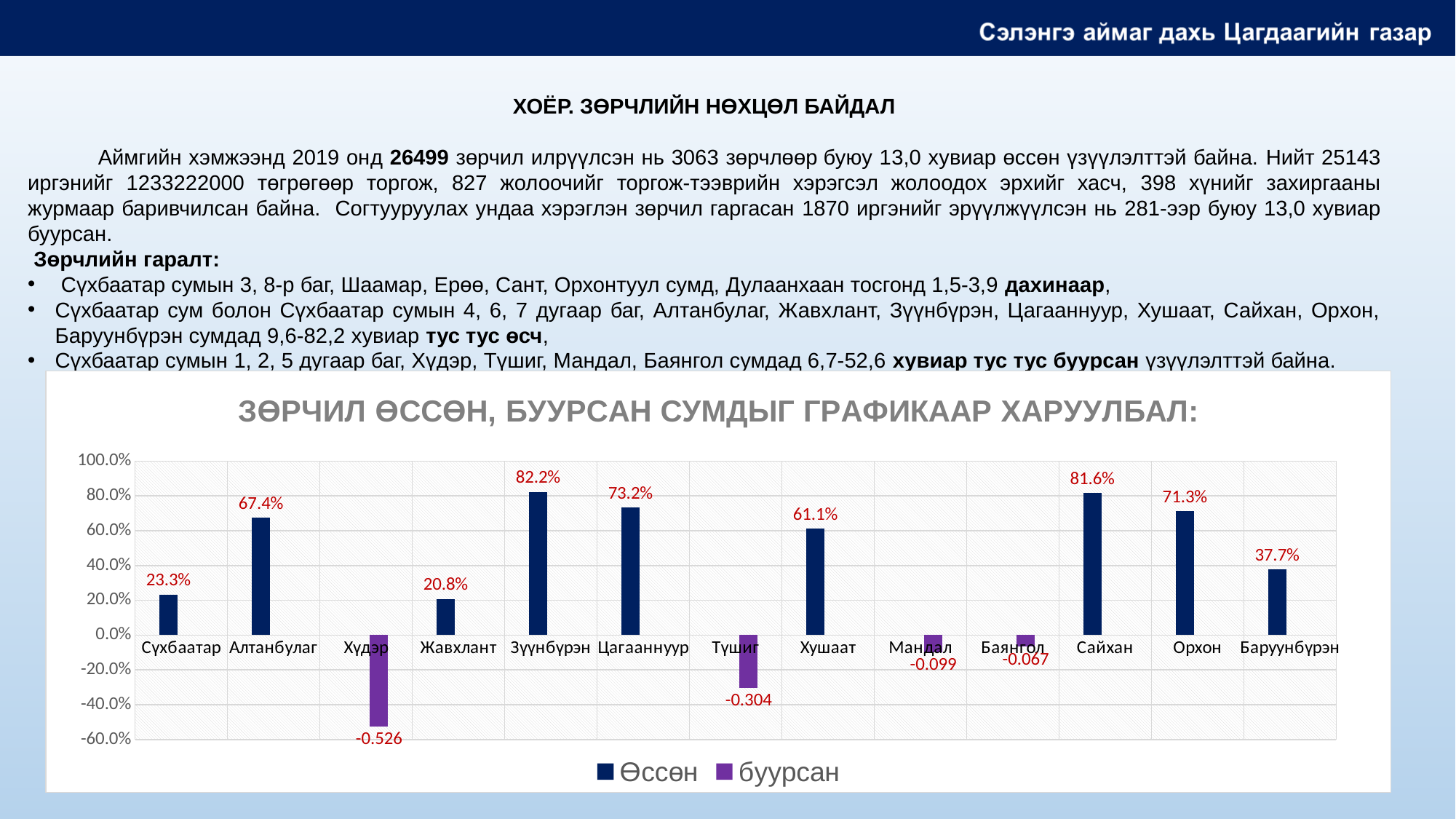
Which is larger, the value for Алтанбулаг or the value for Орхон? Орхон What type of chart is shown on the slide? bar chart How many series does the legend list? 2 What is the value shown for Мандал? -0.099 How many categories are shown on the x axis of the chart? 13 What is the value shown for Баруунбүрэн? 37.7% What is the value shown for Зүүнбүрэн? 82.2% What is the value shown for Хүдэр? -0.526 Which category has the highest value in the chart? Зүүнбүрэн What are the two legend entries of the chart? Өссөн and буурсан Which category has the lowest value in the chart? Хүдэр What is the difference between the values for Зүүнбүрэн and Цагааннуур? 9.0 percentage points